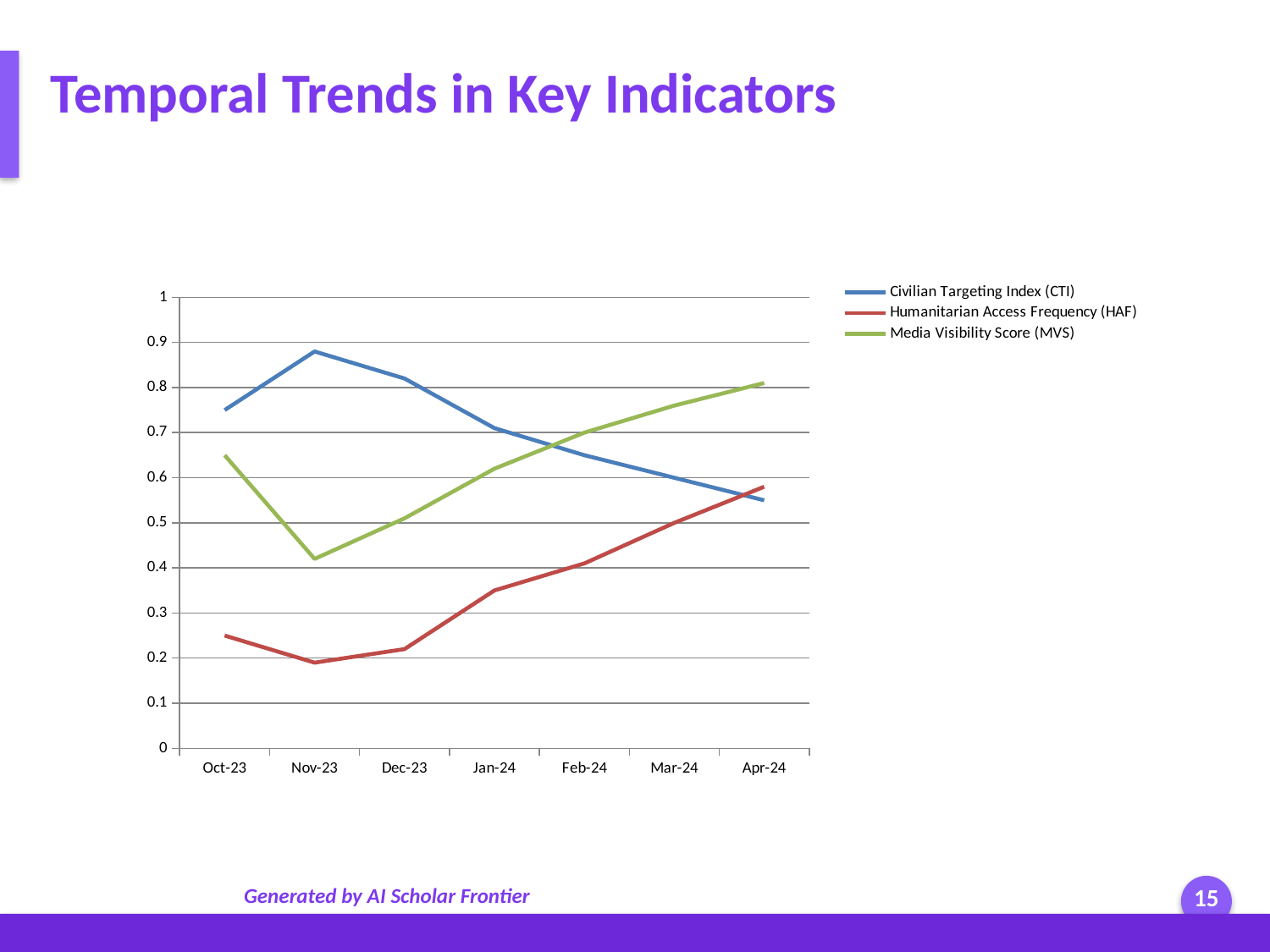
Is the Civilian Targeting Index (CTI) value for Nov-23 greater or less than 0.8? greater In which month is the Humanitarian Access Frequency (HAF) at its lowest? Nov-23 Which series has the higher value in Apr-24, Civilian Targeting Index (CTI) or Media Visibility Score (MVS)? Media Visibility Score (MVS) How many series does the legend list? 3 How many months are shown on the x axis? 7 Is the Media Visibility Score (MVS) value for Nov-23 greater or less than 0.5? less In which month is the Media Visibility Score (MVS) at its lowest? Nov-23 Does the Civilian Targeting Index (CTI) rise or fall from Nov-23 to Apr-24? fall Is the Humanitarian Access Frequency (HAF) value for Oct-23 greater or less than 0.3? less What kind of chart is shown on the slide? line chart In which month does the Civilian Targeting Index (CTI) reach its highest value? Nov-23 Does the Humanitarian Access Frequency (HAF) rise or fall from Nov-23 to Apr-24? rise